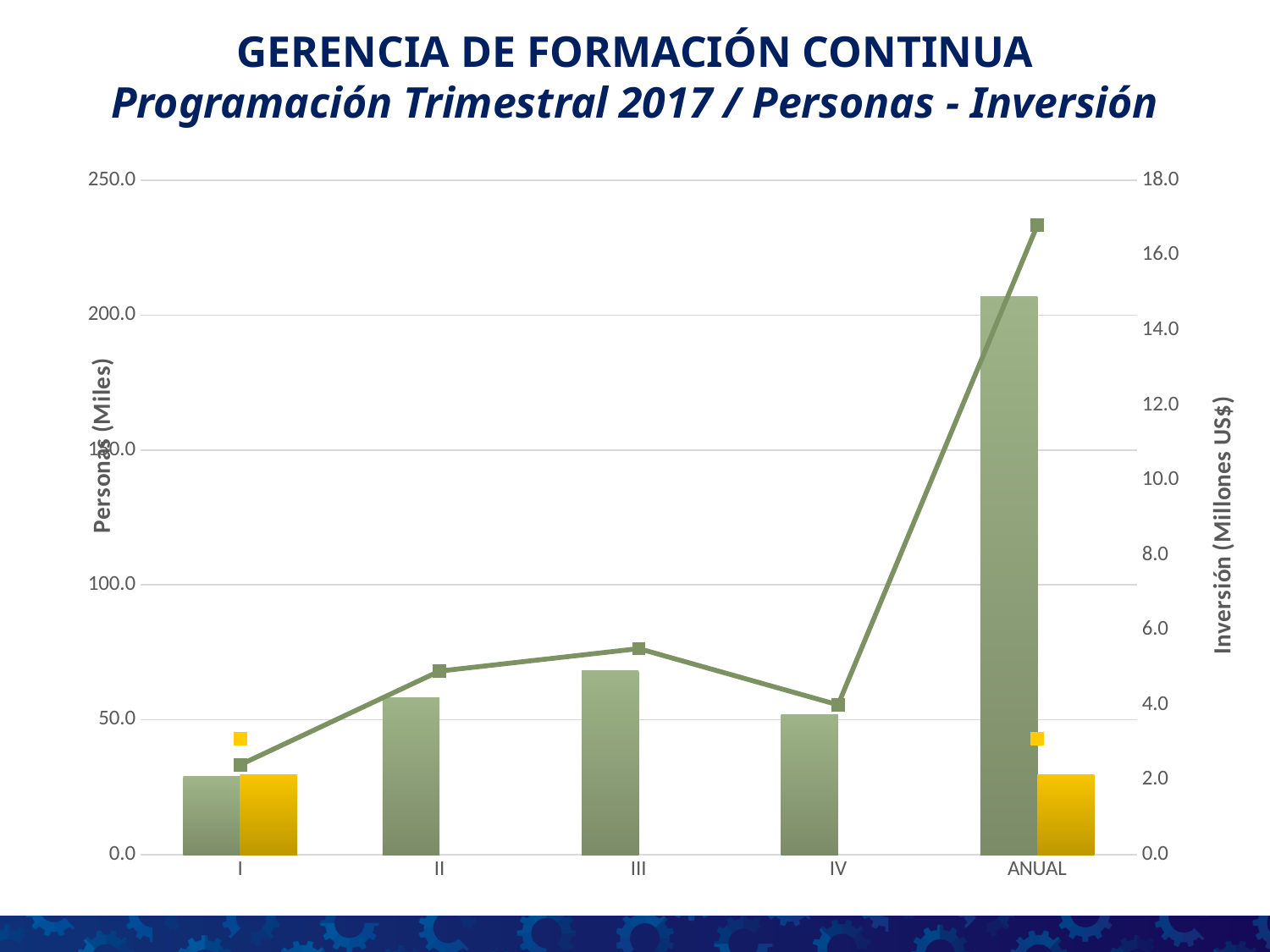
Do the green bars rise or fall from category I to category III? rise Is the green bar for I greater or less than 50 on the left axis? less Is the green line value for ANUAL greater or less than 16.0 on the right axis? greater Which category has the tallest green bar? ANUAL At which category does the green line reach its highest point? ANUAL Is the green bar for III greater or less than 50 on the left axis? greater What kind of chart is shown on the slide? A combination bar and line chart What is the title of the right-hand vertical axis? Inversión (Millones US$) Which category has the shortest green bar? I How many categories are shown on the x axis? 5 Which is taller, the green bar for II or the green bar for III? III